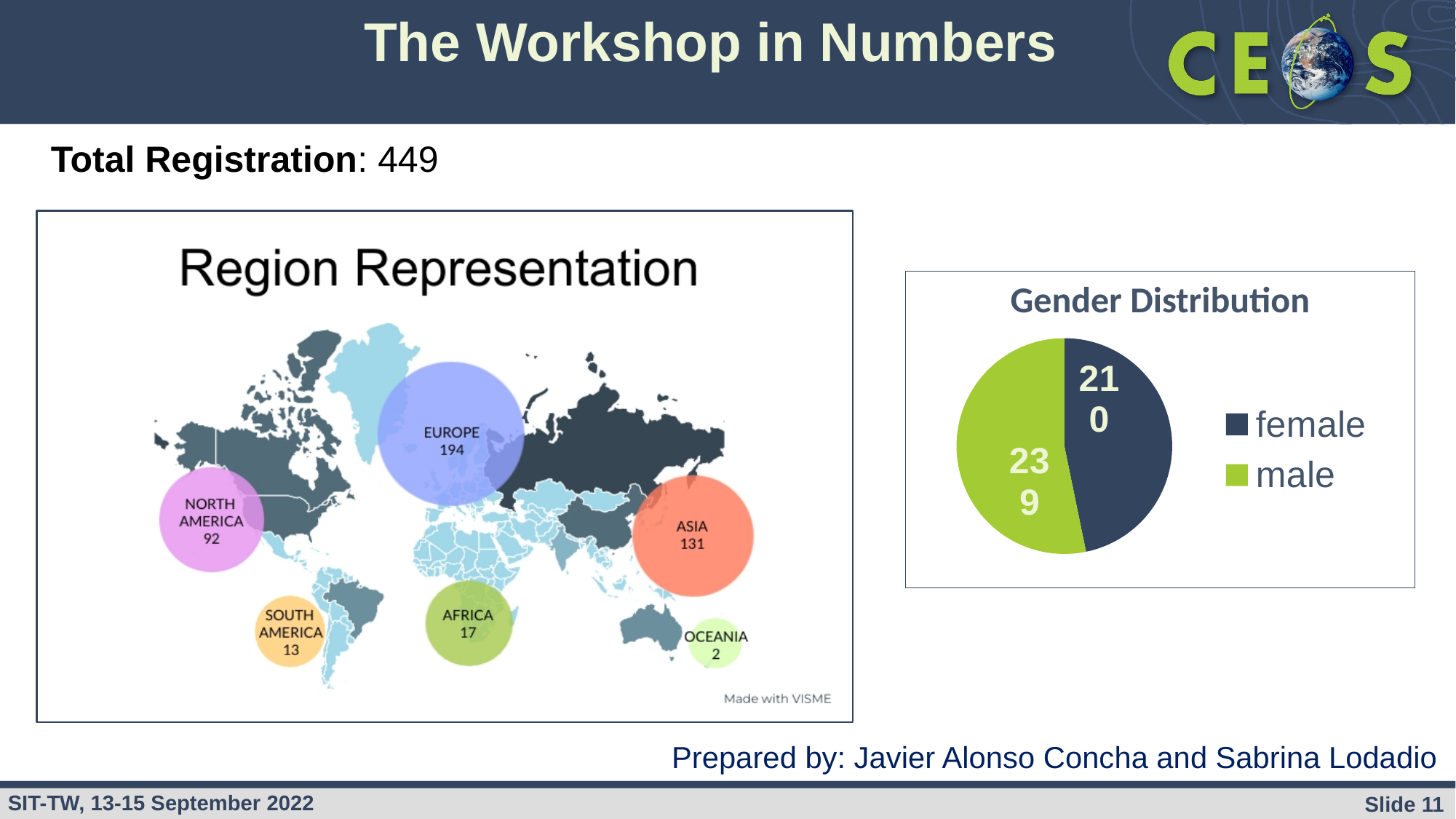
In the Gender Distribution chart, which category has the larger value, female or male? male In the Region Representation chart, which region has the lowest value? Oceania In the Region Representation chart, which region has the highest value? Europe What kind of chart is the Gender Distribution chart? pie chart In the Region Representation chart, what is the value for Europe? 194 In the Gender Distribution chart, what is the value for female? 210 In the Region Representation chart, what is the value for Asia? 131 In the Gender Distribution chart, which colour represents male? green In the Gender Distribution chart, what is the value for male? 239 In the Gender Distribution chart, how many entries does the legend list? 2 In the Gender Distribution chart, what is the difference between the male and female values? 29 In the Region Representation chart, how many regions are shown? 6